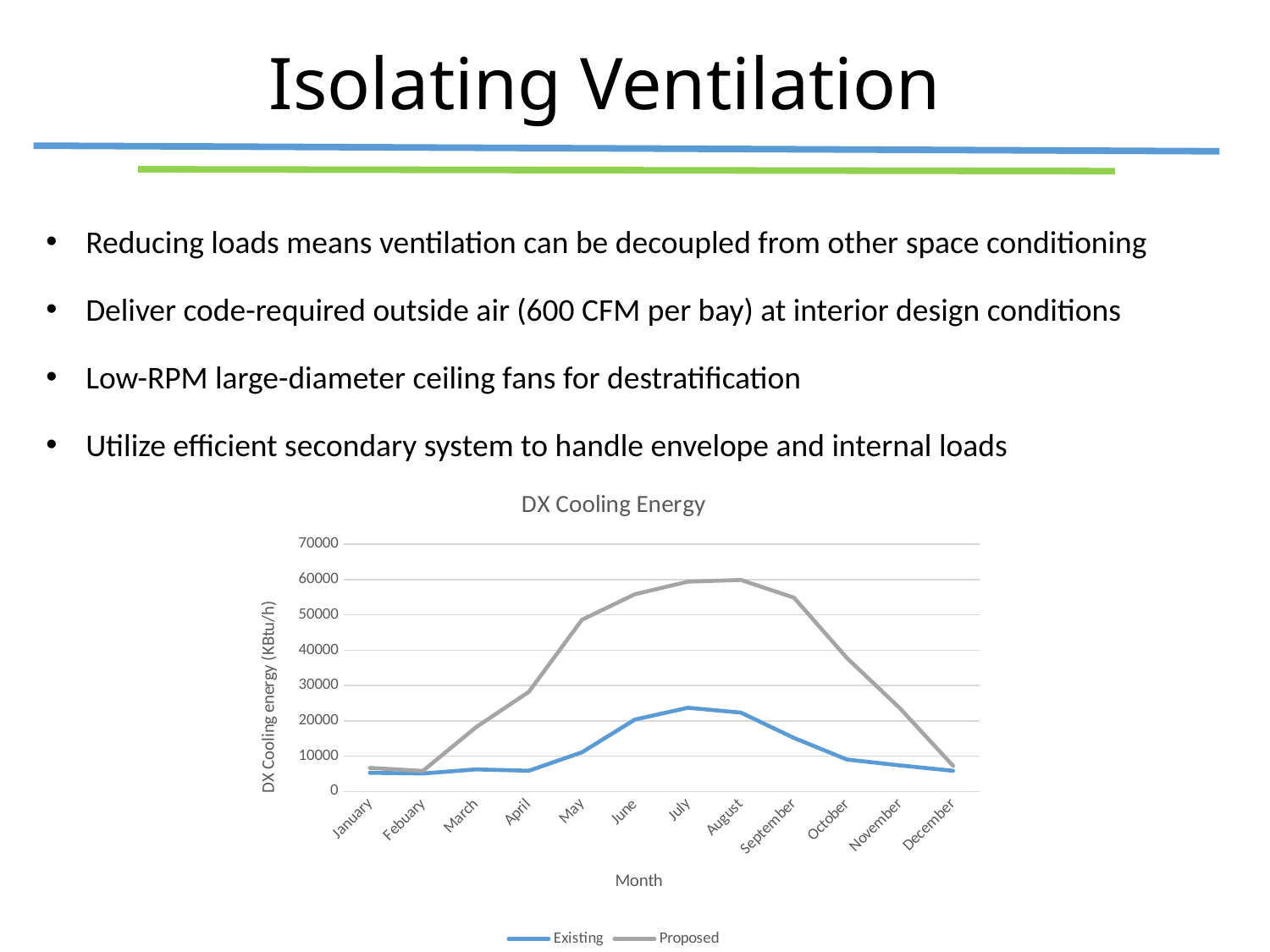
How many series does the legend of the DX Cooling Energy chart list? 2 What is the title of the chart on the slide? DX Cooling Energy Is the Proposed value for December greater or less than 10000? less Does the Proposed series rise or fall from August to December? Fall How many months are plotted along the x axis of the DX Cooling Energy chart? 12 What kind of chart is shown on the slide? Line chart In July, which series has the larger value, Existing or Proposed? Proposed Is the Existing value for July greater or less than 30000? less Is the Proposed value for May greater or less than 40000? greater What is the label on the vertical axis of the chart? DX Cooling energy (KBtu/h)